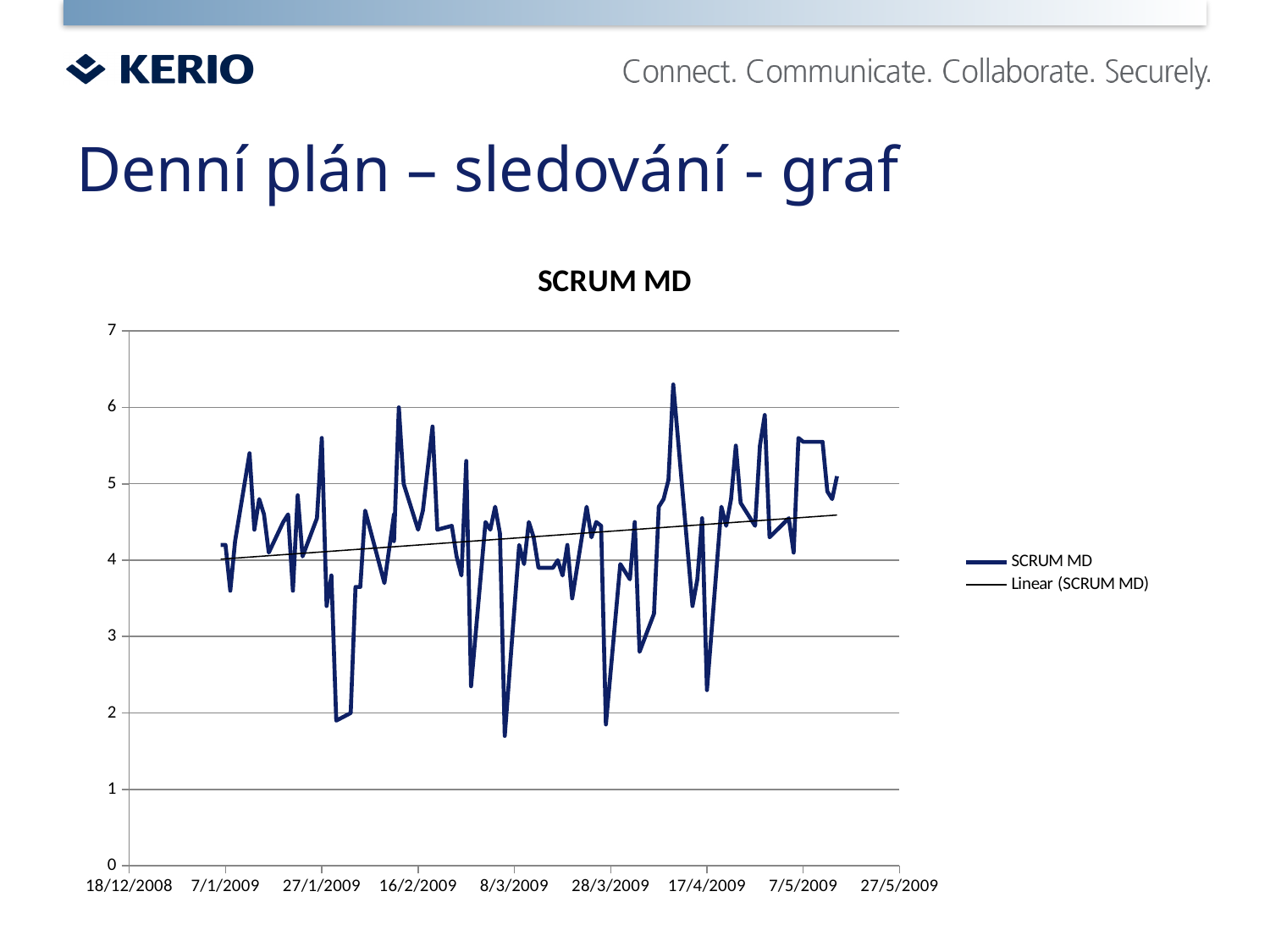
What is the title of the chart? SCRUM MD What kind of chart is shown on the slide? line chart What is the highest value shown on the y axis? 7 Is the lowest value of the SCRUM MD series greater or less than 2? less Does the linear trendline rise or fall from left to right along the x axis? rise Is the value of the linear trendline at its left end greater or less than 5? less Is the value of the linear trendline at its right end greater or less than 4? greater How many series does the legend list? 2 What are the two entries in the chart legend? SCRUM MD and Linear (SCRUM MD)